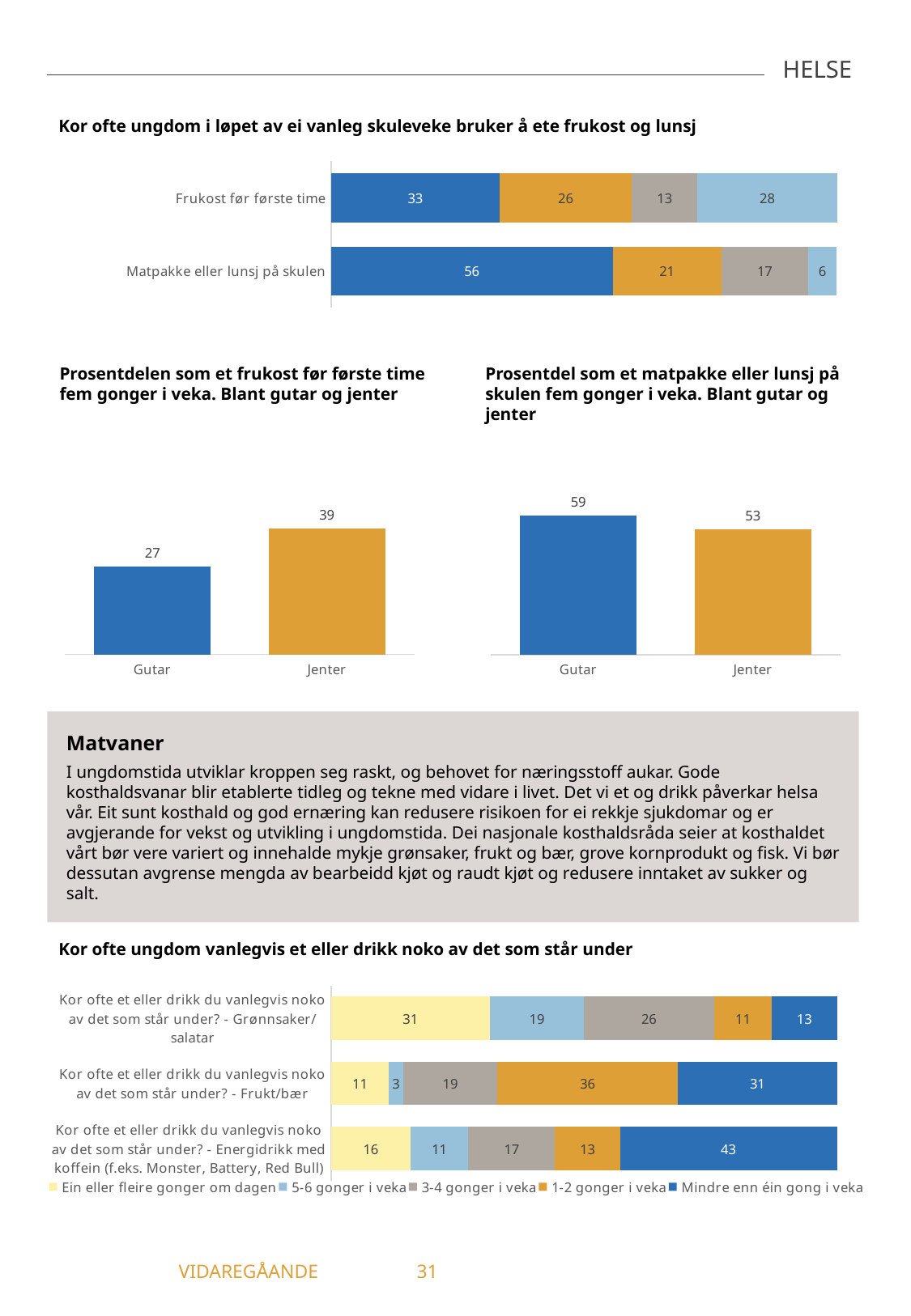
In the chart 'Prosentdelen som et frukost før første time fem gonger i veka', what is the difference between Jenter and Gutar? 12 In the chart 'Prosentdelen som et frukost før første time fem gonger i veka', what is the value for Gutar? 27 In the bottom chart 'Kor ofte ungdom vanlegvis et eller drikk noko av det som står under', how many series does the legend list? 5 In the chart 'Prosentdel som et matpakke eller lunsj på skulen fem gonger i veka', which group has the higher value, Gutar or Jenter? Gutar In the bottom chart 'Kor ofte ungdom vanlegvis et eller drikk noko av det som står under', what is the value for '5-6 gonger i veka' for Frukt/bær? 3 What kind of chart is the bottom chart 'Kor ofte ungdom vanlegvis et eller drikk noko av det som står under'? Stacked bar chart In the bottom chart 'Kor ofte ungdom vanlegvis et eller drikk noko av det som står under', which category has the highest value for 'Ein eller fleire gonger om dagen'? Grønnsaker/salatar In the chart 'Prosentdel som et matpakke eller lunsj på skulen fem gonger i veka', what is the value for Jenter? 53 In the top chart 'Kor ofte ungdom i løpet av ei vanleg skuleveke bruker å ete frukost og lunsj', what is the value of the first (blue) segment for 'Matpakke eller lunsj på skulen'? 56 In the top chart 'Kor ofte ungdom i løpet av ei vanleg skuleveke bruker å ete frukost og lunsj', what is the total of the stacked bar for 'Frukost før første time'? 100 In the bottom chart 'Kor ofte ungdom vanlegvis et eller drikk noko av det som står under', what is the value for 'Mindre enn éin gong i veka' for Energidrikk med koffein? 43 In the top chart 'Kor ofte ungdom i løpet av ei vanleg skuleveke bruker å ete frukost og lunsj', how many categories are shown? 2